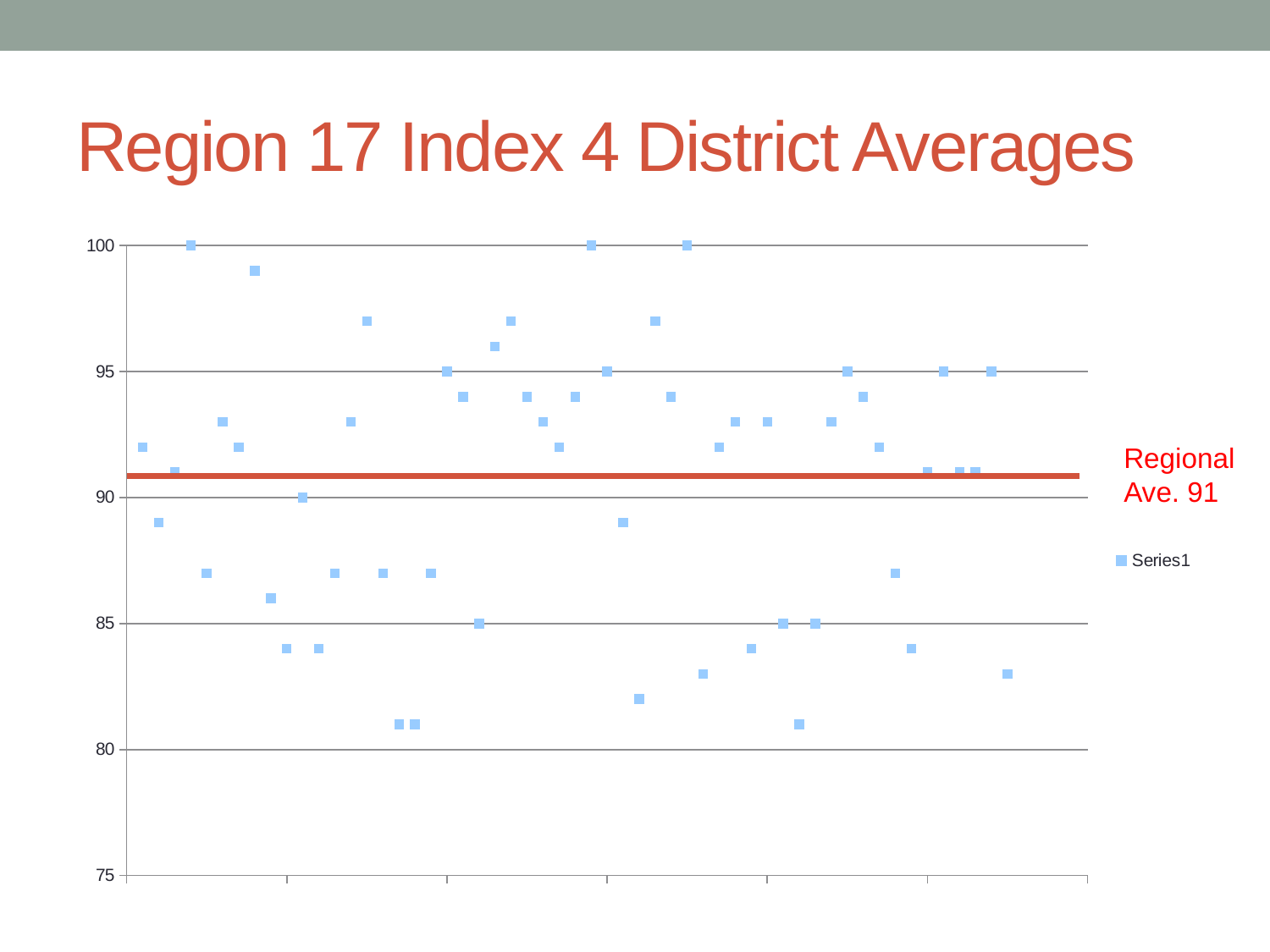
What kind of chart is shown on the slide? scatter chart What is the highest value shown on the vertical axis? 100 Is the Regional Ave. line greater or less than 90? greater What is the highest value reached by any plotted point? 100 What value is given for the Regional Ave. marked by the horizontal line? 91 How many series does the legend list? 1 Is the lowest plotted point greater or less than 85? less Is the highest plotted point greater or less than 95? greater What is the name of the series shown in the legend? Series1 What is the title of the chart? Region 17 Index 4 District Averages What is the lowest value shown on the vertical axis? 75